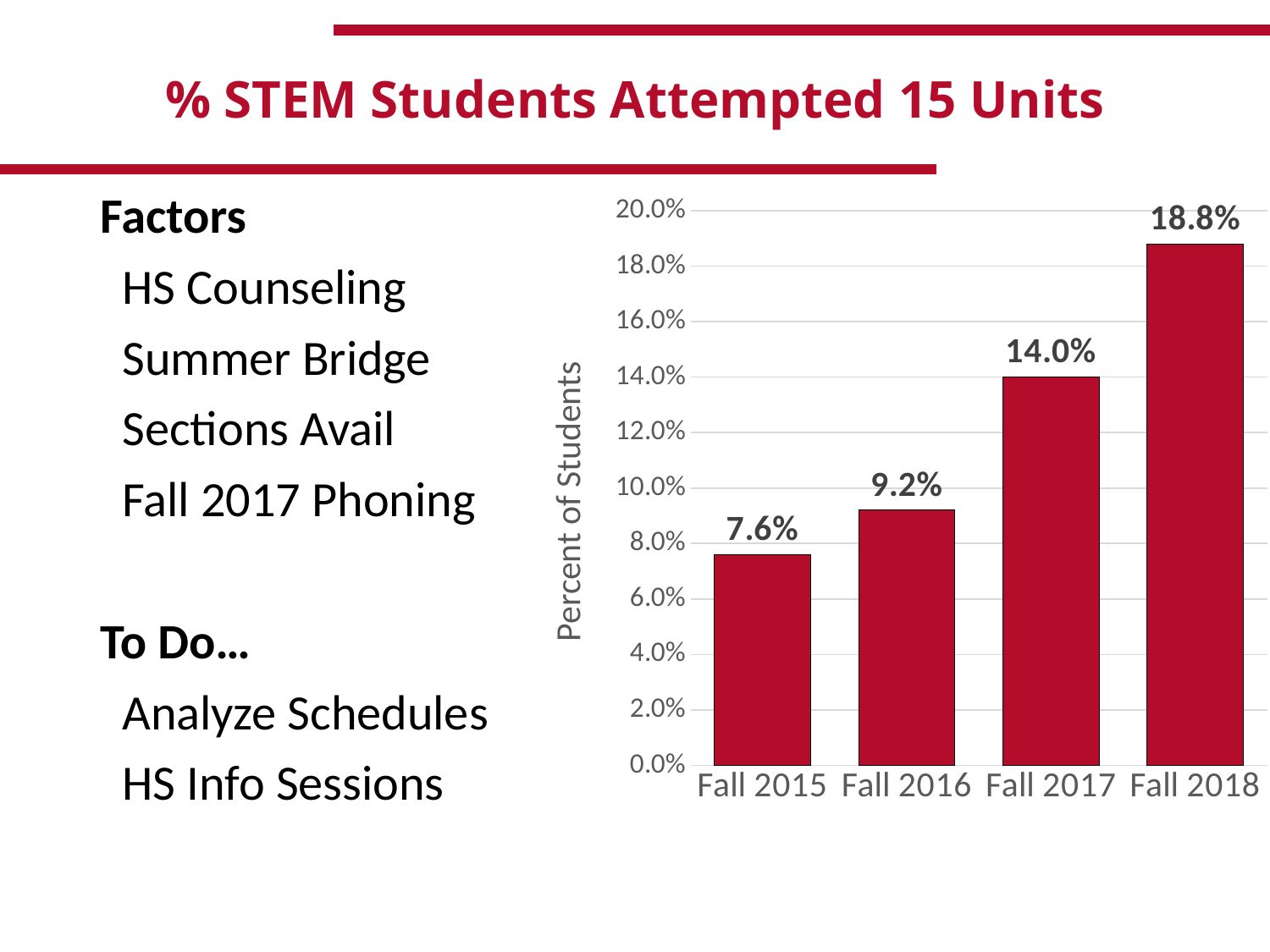
How many categories are shown on the x axis? 4 Which category has the highest value? Fall 2018 What kind of chart is shown on the slide? Bar chart What is the value for Fall 2016? 9.2% What is the value for Fall 2018? 18.8% What is the value for Fall 2015? 7.6% Do the values rise or fall from Fall 2015 to Fall 2018? Rise Which category has the lowest value? Fall 2015 What is the value for Fall 2017? 14.0% Which is larger, the value for Fall 2016 or the value for Fall 2017? Fall 2017 What is the difference between the values for Fall 2017 and Fall 2016? 4.8% What is the difference between the values for Fall 2018 and Fall 2015? 11.2%